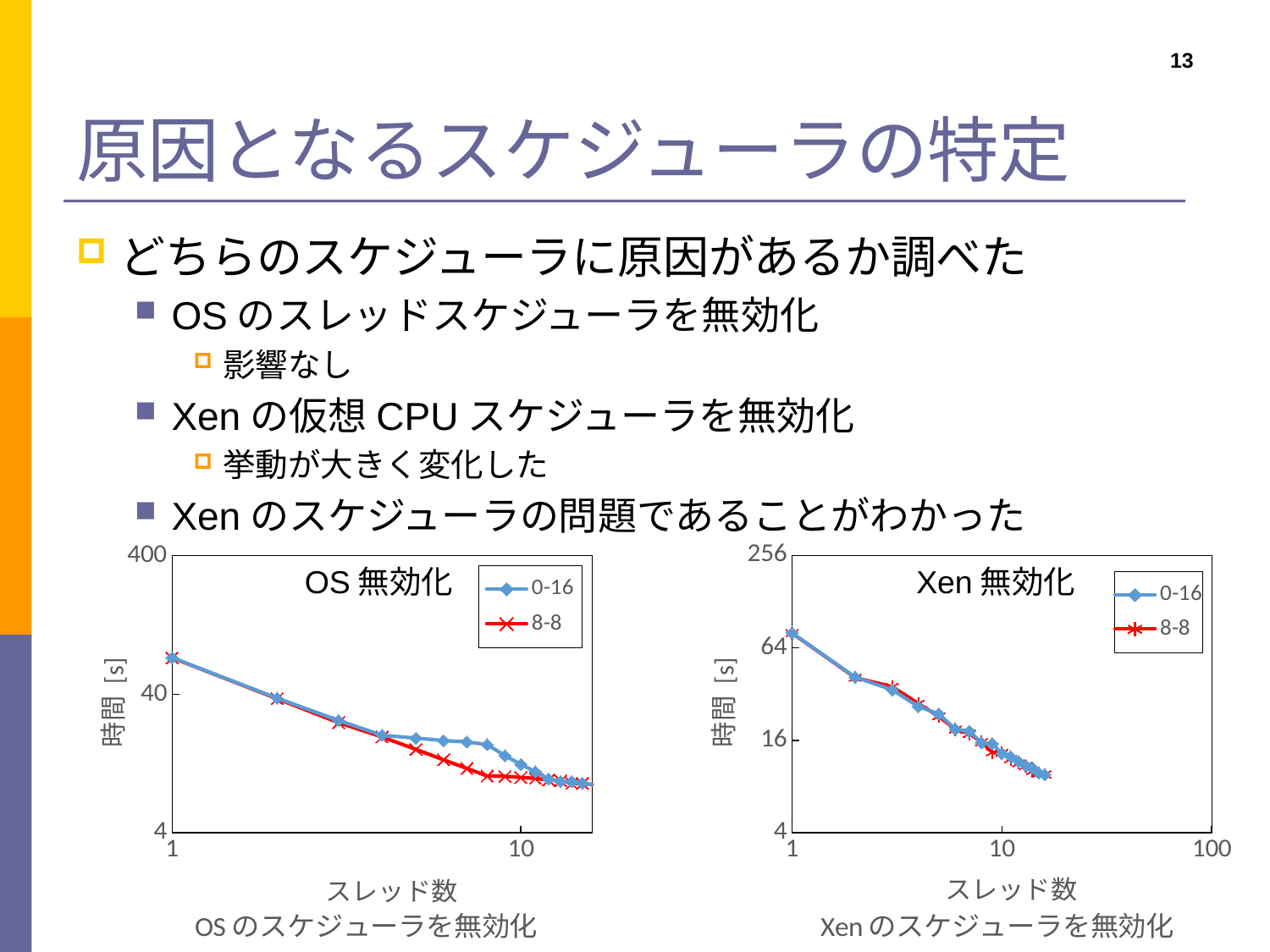
In the Xen 無効化 chart, do the values of the 0-16 series rise or fall as the thread count increases? fall What kind of chart is the right chart titled Xen 無効化? line chart In the OS 無効化 chart, is the value of the 8-8 series at 10 threads greater or less than 40? less In the OS 無効化 chart, is the value of the 0-16 series at 1 thread greater or less than 40? greater What kind of chart is the left chart titled OS 無効化? line chart In the OS 無効化 chart, do the values of the 8-8 series rise or fall as the thread count increases? fall How many series does the legend of the OS 無効化 chart list? 2 In the Xen 無効化 chart, is the value of the 8-8 series at 10 threads greater or less than 16? less How many series does the legend of the Xen 無効化 chart list? 2 What is the y-axis label of the OS 無効化 chart? 時間 [s] What are the two legend entries in the Xen 無効化 chart? 0-16 and 8-8